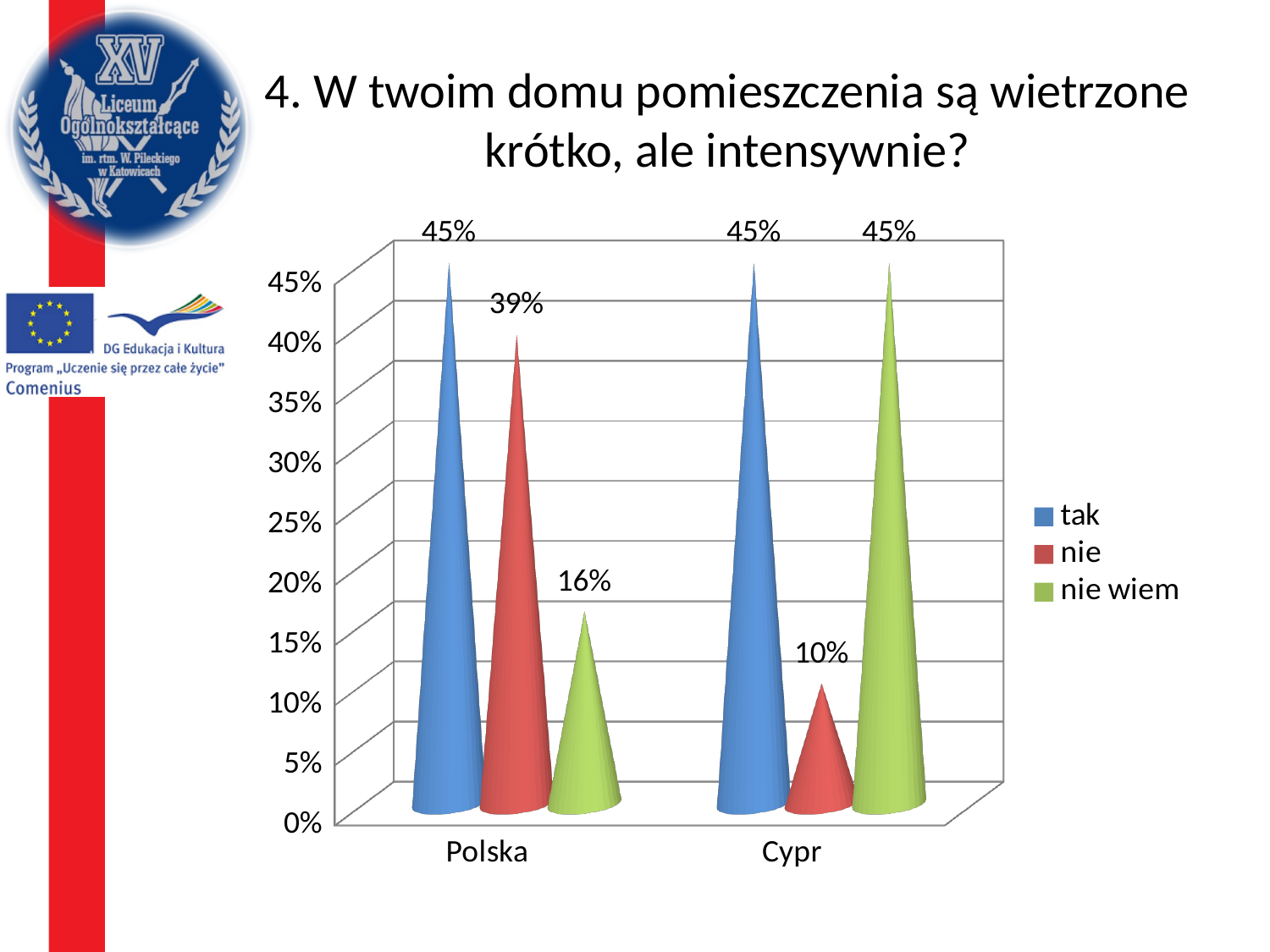
What is the value for "nie wiem" in Cypr? 45% What is the difference between the "nie" values for Polska and Cypr? 29% What is the value for "nie" in Polska? 39% How many categories are shown on the x axis? 2 How many series does the legend list? 3 What is the value for "nie" in Cypr? 10% Which is larger: "nie wiem" in Polska or "nie wiem" in Cypr? nie wiem in Cypr Which series has the lowest value in Cypr? nie What kind of chart is shown on the slide? bar chart What is the value for "nie wiem" in Polska? 16% Which series has the lowest value in Polska? nie wiem What is the value for "tak" in Polska? 45%